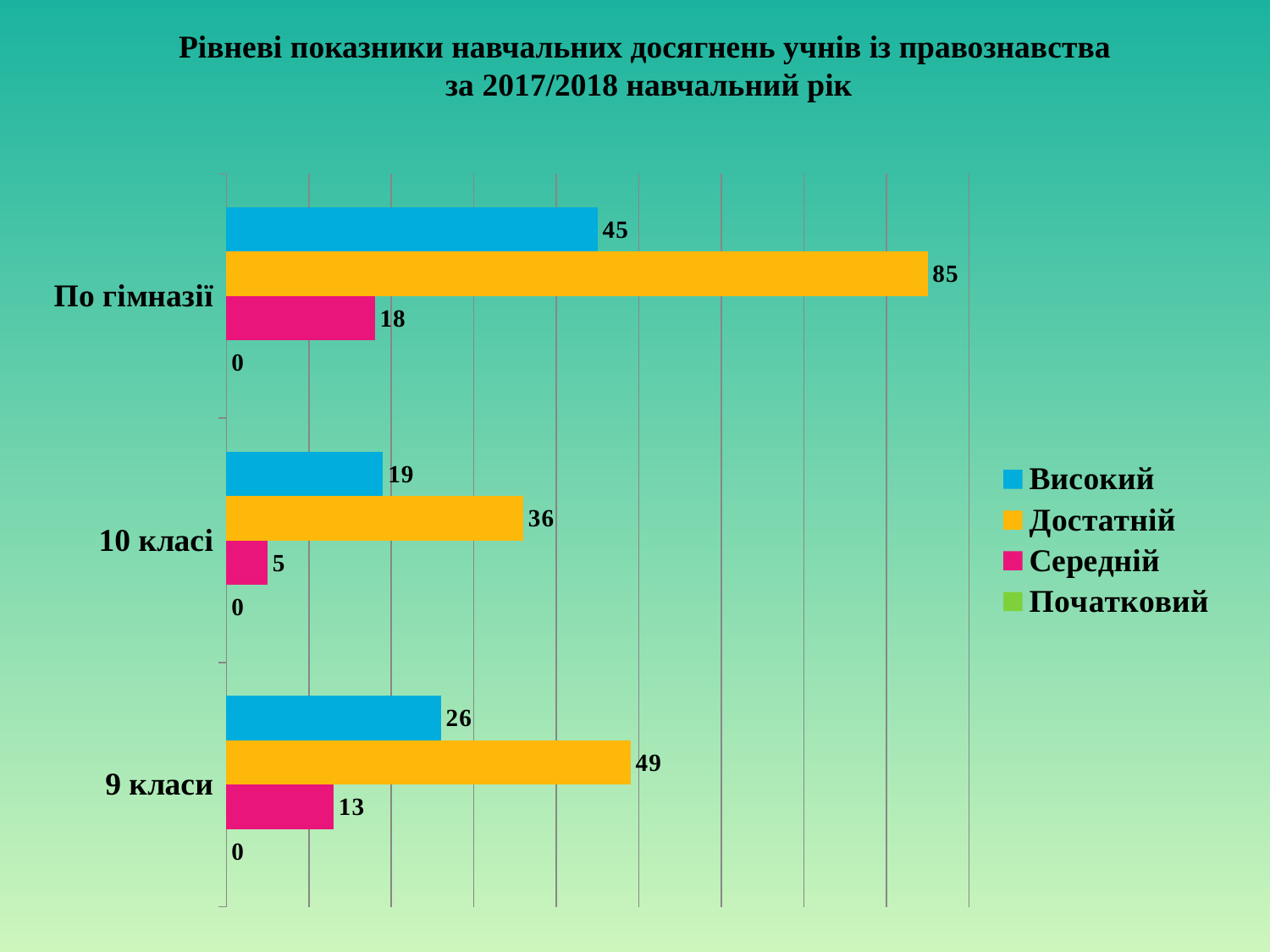
What is the value of Достатній for По гімназії? 85 What is the difference between the Достатній and Високий values for 9 класи? 23 Which category has the lowest value for Середній? 10 класі Which series is shown in pink on the chart? Середній What is the value of Середній for 9 класи? 13 How many categories are shown on the chart? 3 What is the value of Початковий for 9 класи? 0 Which category has the highest value for Достатній? По гімназії What is the value of Високий for 10 класі? 19 Which is larger: the Високий value for 9 класи or the Високий value for 10 класі? 9 класи What type of chart is shown on the slide? bar chart How many series does the legend list? 4